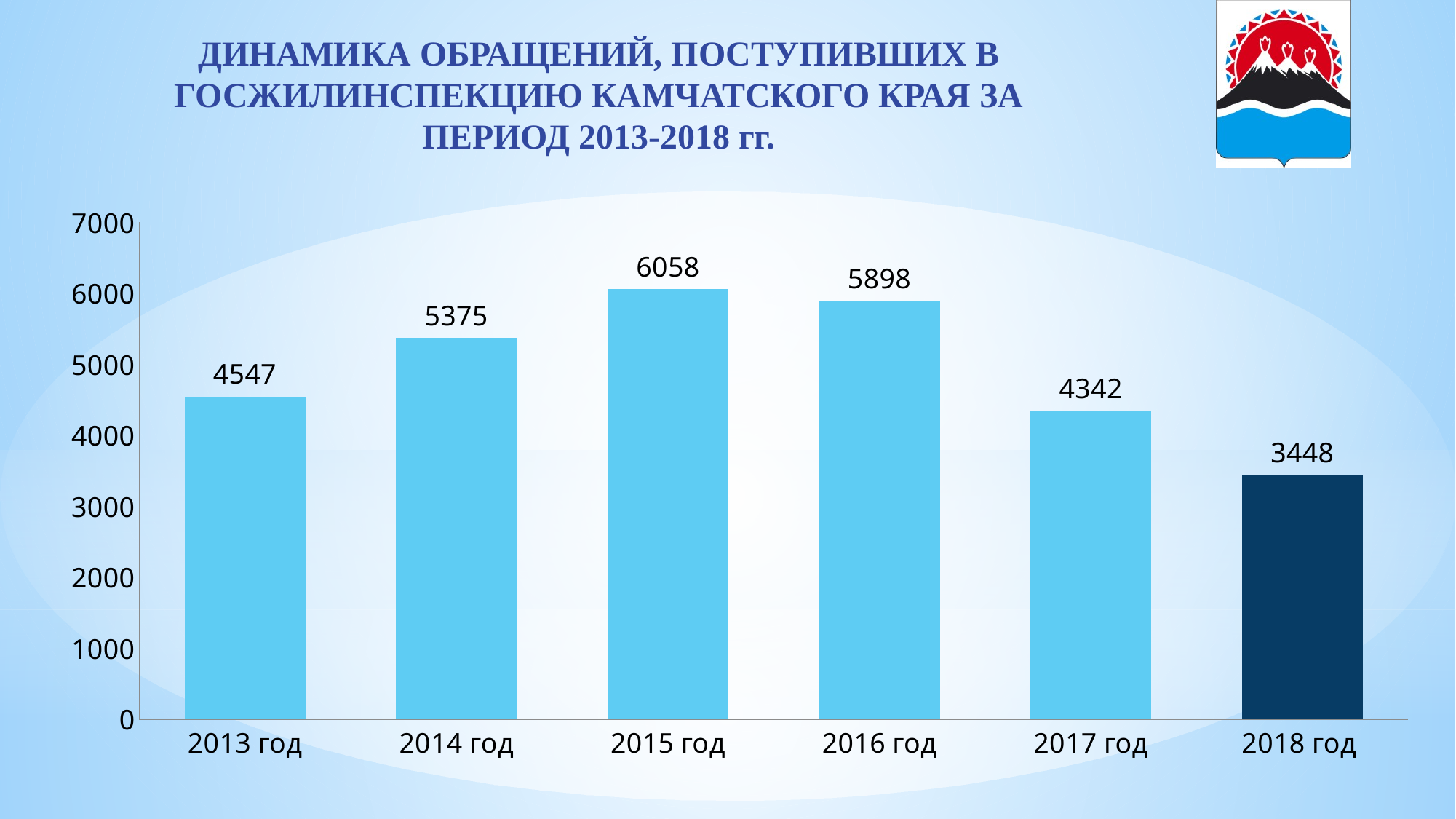
What is the value for 2015 год? 6058 Is the value for 2016 год greater or less than 6000? less What kind of chart is shown on the slide? bar chart What is the difference between the values for 2015 год and 2016 год? 160 Do the values rise or fall from 2016 год to 2018 год? fall How many years are shown on the chart? 6 Which year has the lowest value? 2018 год Which is larger, the value for 2017 год or the value for 2013 год? 2013 год What is the value for 2013 год? 4547 Which year has the highest value? 2015 год What is the value for 2018 год? 3448 What is the difference between the values for 2014 год and 2013 год? 828